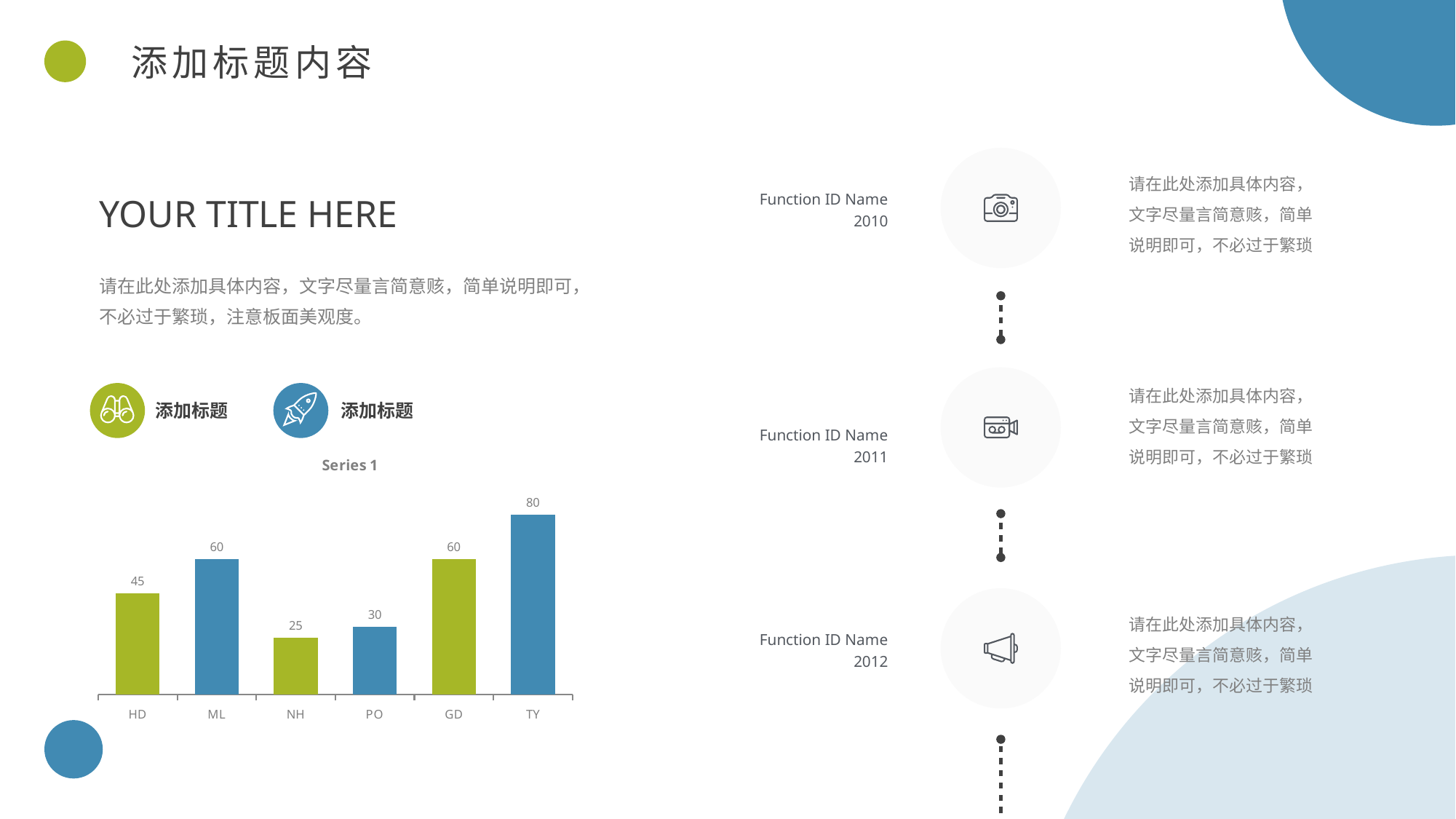
What is the value for TY in the chart? 80 What is the value for ML in the chart? 60 What is the difference between the values for GD and PO? 30 What kind of chart is shown on the slide? bar chart What is the title of the chart? Series 1 Which category has the lowest value in the chart? NH Which category has the highest value in the chart? TY What is the value for NH in the chart? 25 What is the value for HD in the chart? 45 How many categories are shown on the x axis of the chart? 6 Which is larger, the value for PO or the value for HD? HD What is the difference between the values for TY and HD? 35